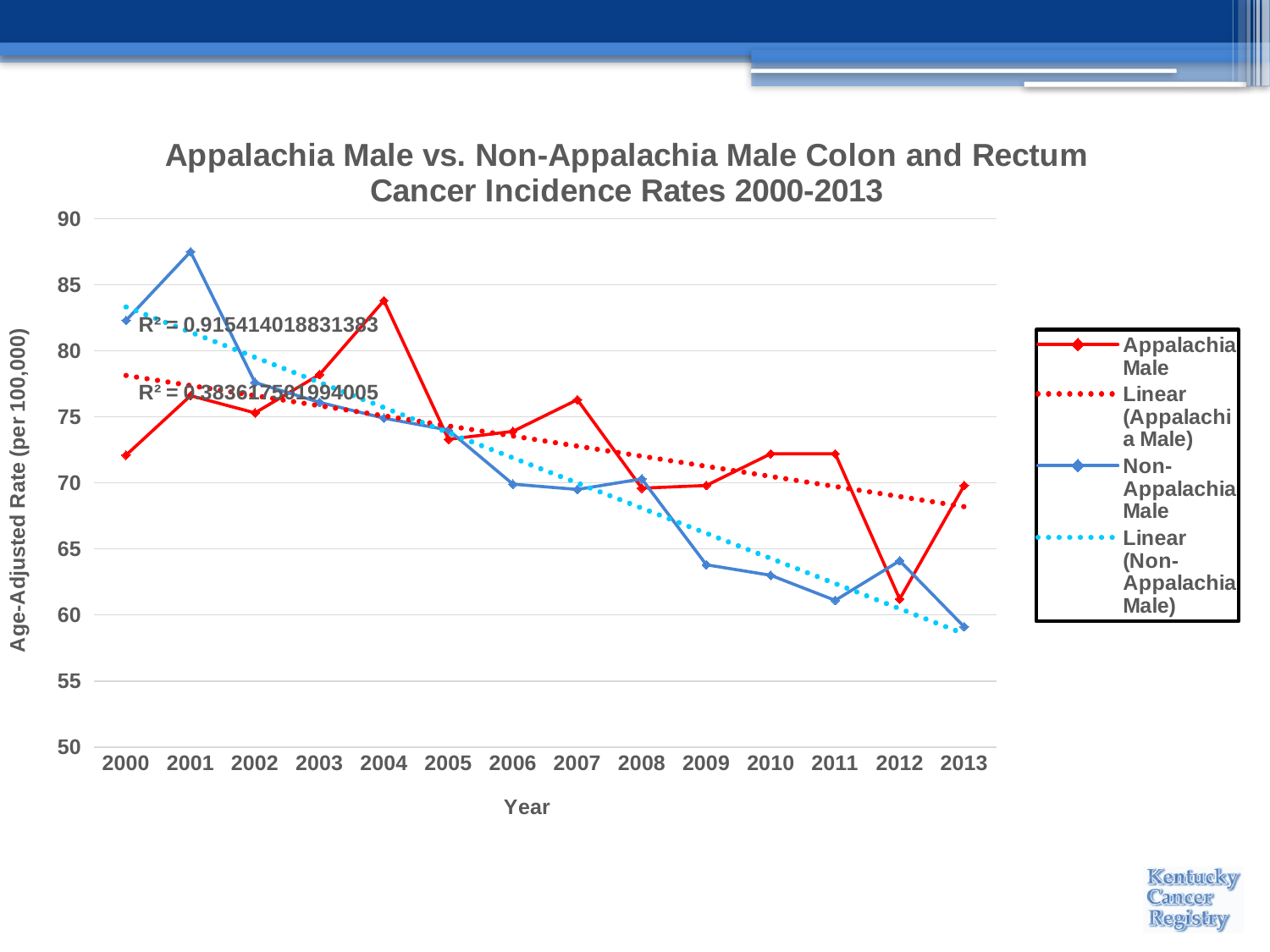
What kind of chart is shown on the slide? Line chart In which year does the Appalachia Male series reach its lowest value? 2012 In which year does the Non-Appalachia Male series reach its lowest value? 2013 Is the value for Appalachia Male in 2012 greater or less than 65? less In 2010, which series has the higher value, Appalachia Male or Non-Appalachia Male? Appalachia Male In 2001, which series has the higher value, Appalachia Male or Non-Appalachia Male? Non-Appalachia Male In which year does the Non-Appalachia Male series reach its highest value? 2001 How many years are plotted along the x axis? 14 Is the value for Non-Appalachia Male in 2001 greater or less than 85? greater How many entries does the legend list? 4 Overall, does the Non-Appalachia Male series rise or fall from 2000 to 2013? Fall In which year does the Appalachia Male series reach its highest value? 2004